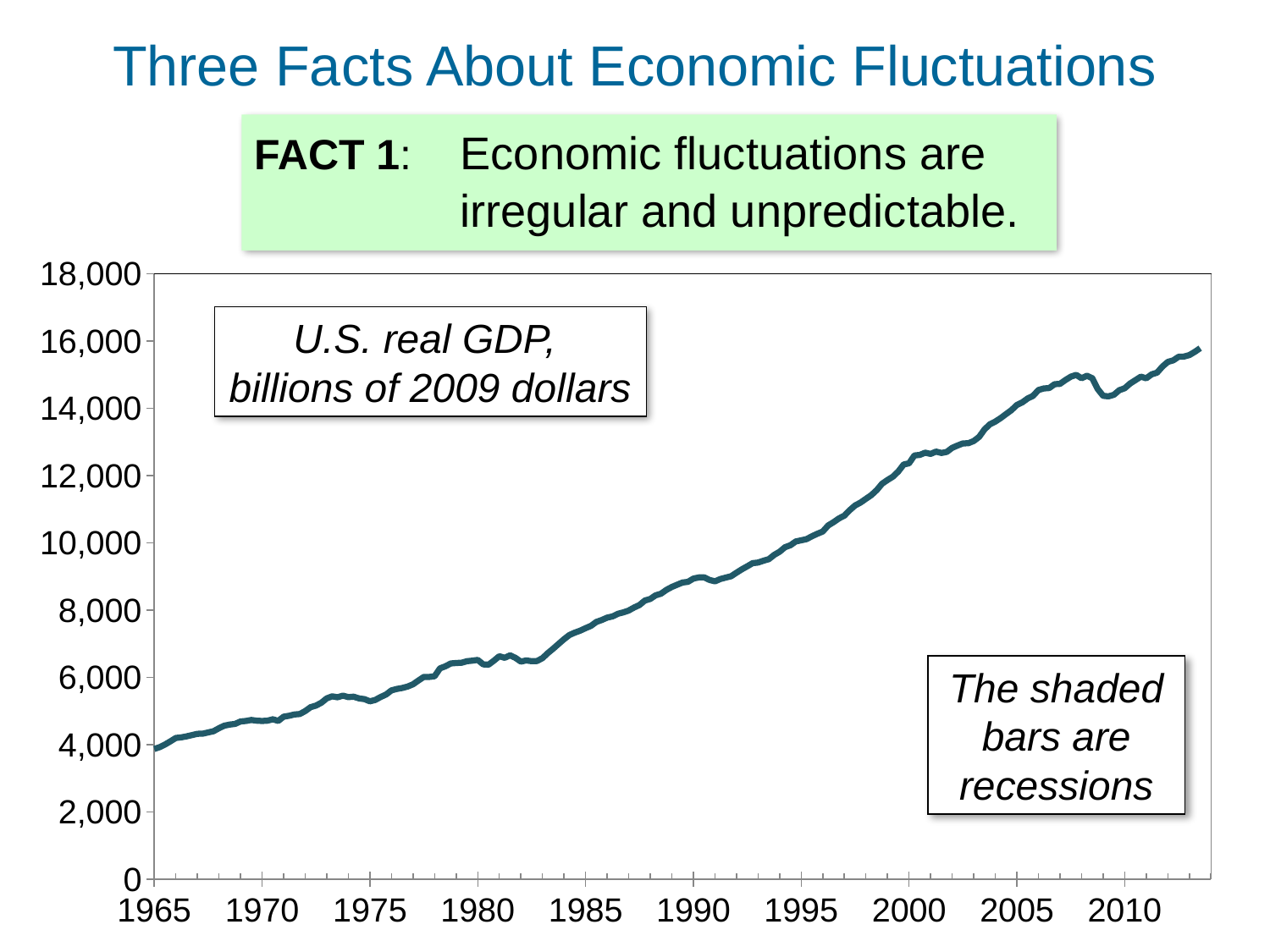
According to the note on the chart, what do the shaded bars represent? recessions Overall, does U.S. real GDP rise or fall from 1965 to the end of the series? rise Is the value of U.S. real GDP in 2000 greater or less than 10,000? greater Is the value of U.S. real GDP in 1975 greater or less than 6,000? less What is the highest value shown on the vertical axis of the chart? 18,000 Which year has the higher U.S. real GDP, 1985 or 2005? 2005 Is the value of U.S. real GDP in 1965 greater or less than 6,000? less What kind of chart is shown on the slide? line chart What does the chart's label say is being plotted? U.S. real GDP, billions of 2009 dollars